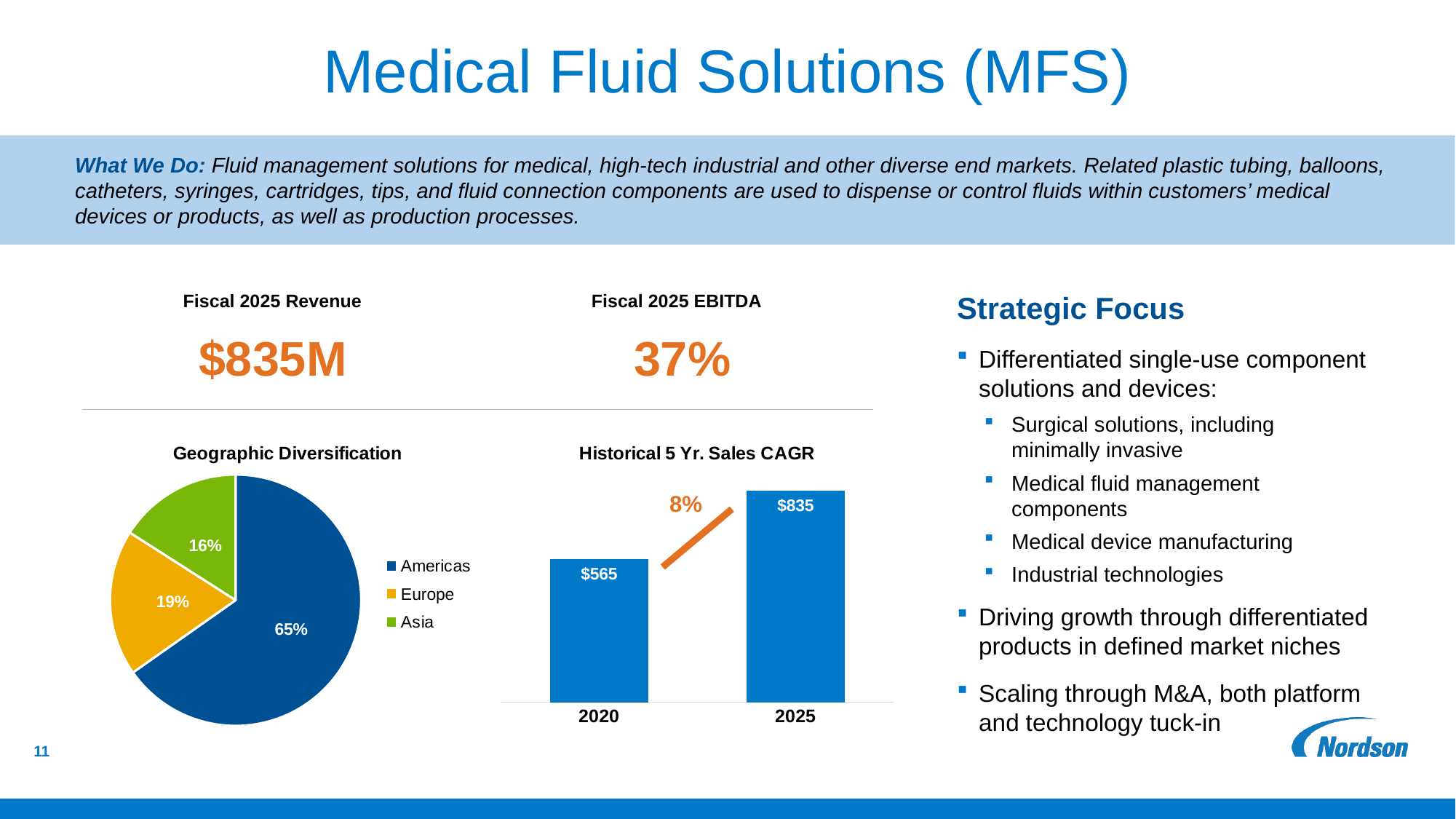
How many regions does the legend of the Geographic Diversification chart list? 3 In the Historical 5 Yr. Sales CAGR chart, what is the value for 2020? $565 In the Geographic Diversification chart, what share of revenue comes from the Americas? 65% In the Historical 5 Yr. Sales CAGR chart, what CAGR percentage is shown between 2020 and 2025? 8% In the Geographic Diversification chart, which region has the largest share? Americas What kind of chart is the Geographic Diversification chart? Pie chart In the Geographic Diversification chart, what share of revenue comes from Asia? 16% In the Geographic Diversification chart, which region has the smallest share? Asia In the Historical 5 Yr. Sales CAGR chart, what is the value for 2025? $835 In the Geographic Diversification chart, what share of revenue comes from Europe? 19% In the Historical 5 Yr. Sales CAGR chart, what is the difference between the 2025 and 2020 values? $270 In the Geographic Diversification chart, what is the difference in percentage points between the Americas and Europe shares? 46